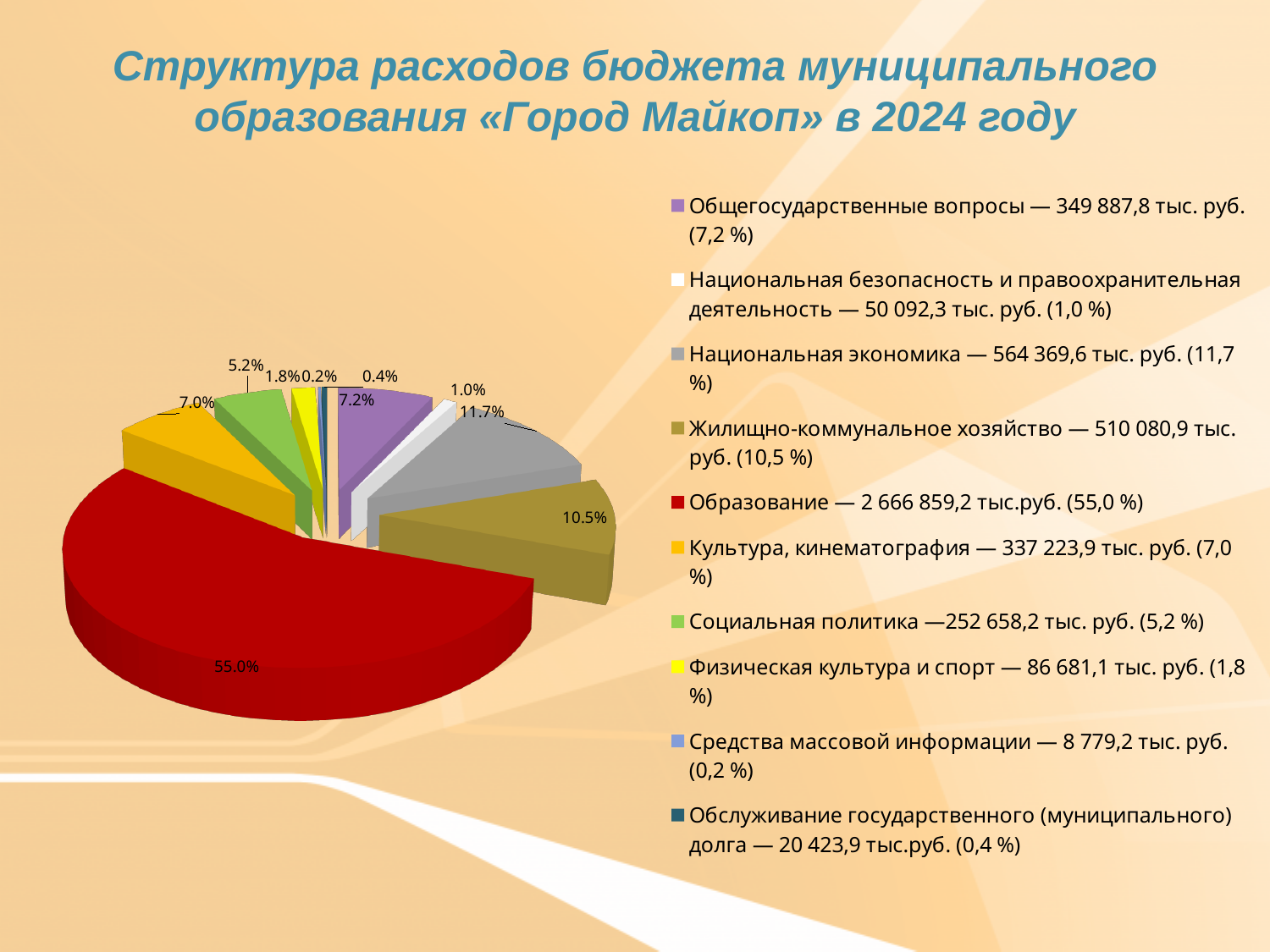
What is the title of the slide? Структура расходов бюджета муниципального образования «Город Майкоп» в 2024 году Which category has the largest share of the pie? Образование Which has the larger share: Общегосударственные вопросы or Культура, кинематография? Общегосударственные вопросы Which category has the smallest share of the pie? Средства массовой информации Is the share for Образование greater or less than 50%? greater How many slices does the pie chart have? 10 What share of the pie does Национальная экономика have? 11.7% According to the legend, what is the amount for Образование? 2 666 859,2 тыс.руб. According to the legend, what is the amount for Социальная политика? 252 658,2 тыс. руб. What share of the pie does Физическая культура и спорт have? 1.8% What kind of chart is shown on the slide? Pie chart By how many percentage points does the share of Национальная экономика exceed that of Жилищно-коммунальное хозяйство? 1.2 percentage points